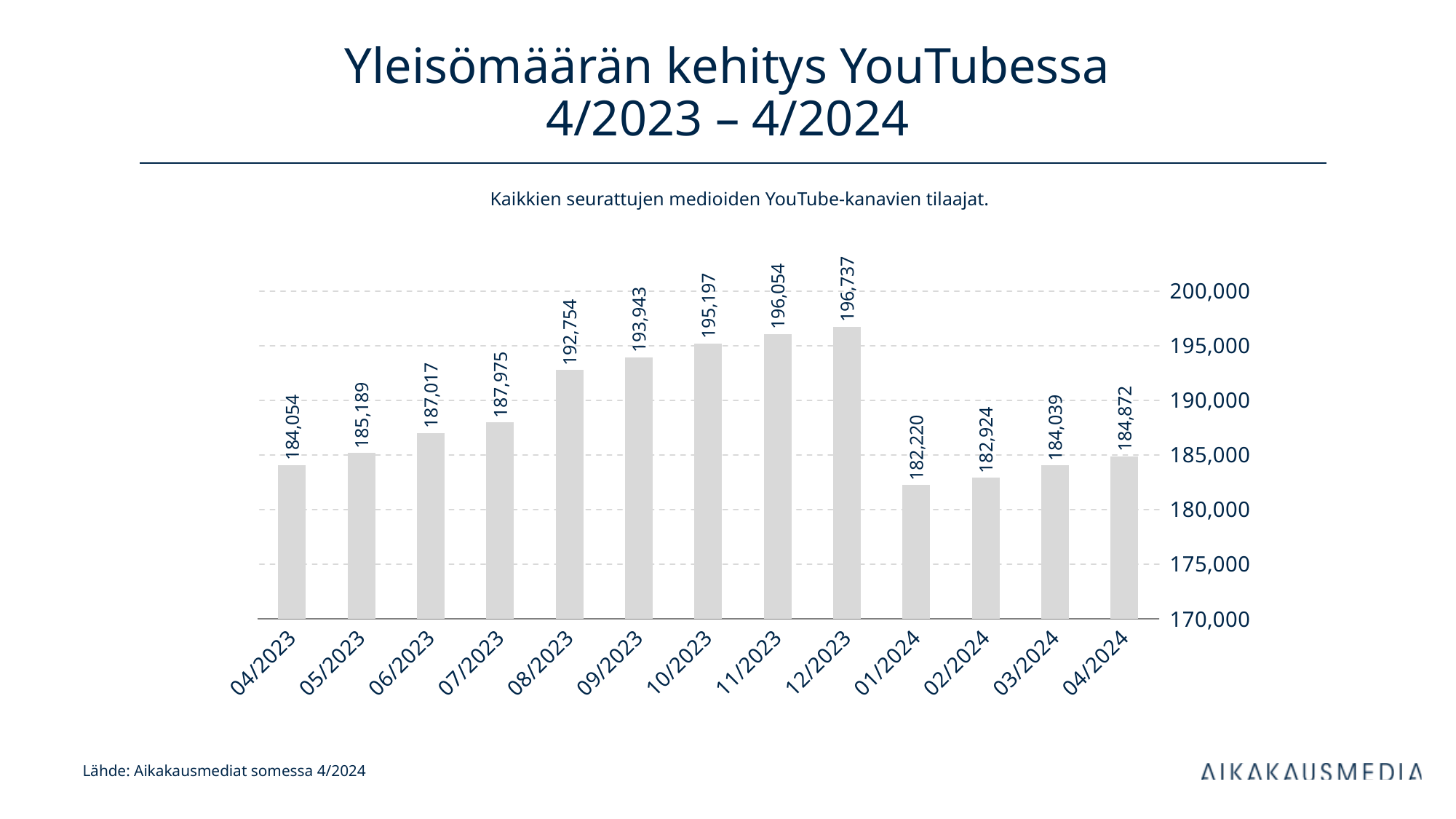
What is the difference between the values for 12/2023 and 01/2024? 14,517 What is the value for 04/2023? 184,054 What is the value for 12/2023? 196,737 What is the value for 01/2024? 182,220 Do the values rise or fall from 04/2023 to 12/2023? Rise Is the value for 10/2023 greater or less than 190,000? greater Which month has the highest value? 12/2023 What kind of chart is shown on the slide? Bar chart How many months are shown on the x axis? 13 Which is larger, the value for 08/2023 or the value for 03/2024? 08/2023 Which month has the lowest value? 01/2024 What is the value for 04/2024? 184,872